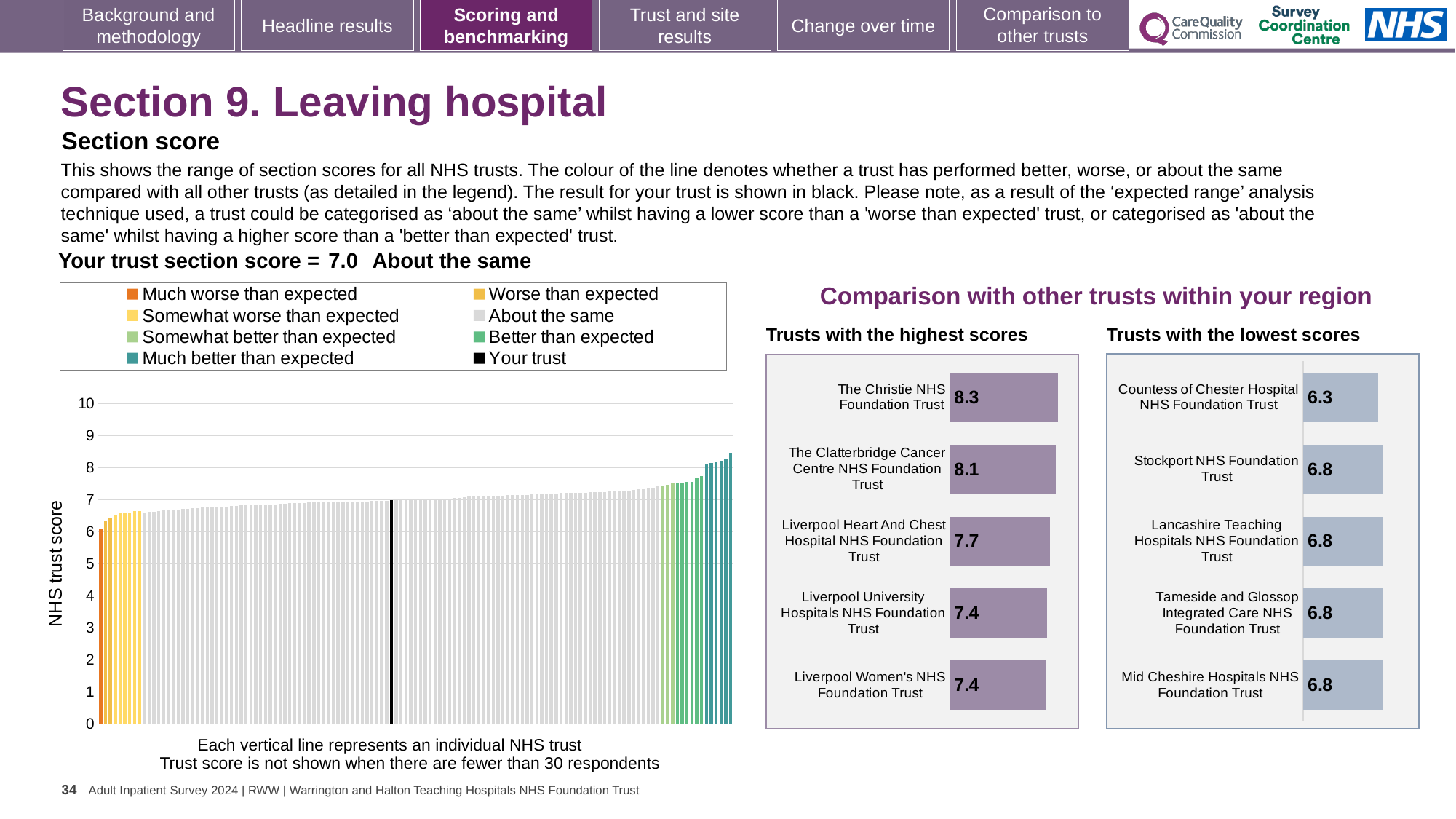
In the 'Trusts with the lowest scores' chart, what is the score for Stockport NHS Foundation Trust? 6.8 In the 'Trusts with the highest scores' chart, is the score for The Clatterbridge Cancer Centre NHS Foundation Trust larger or smaller than the score for Liverpool Women's NHS Foundation Trust? larger How many entries does the legend of the NHS trust score chart on the left list? 8 In the 'Trusts with the lowest scores' chart, how many trusts are shown? 5 In the 'Trusts with the highest scores' chart, which trust has the highest score? The Christie NHS Foundation Trust In the 'Trusts with the highest scores' chart, what is the score for The Christie NHS Foundation Trust? 8.3 In the NHS trust score chart on the left, do the trust scores rise or fall from left to right? rise In the 'Trusts with the lowest scores' chart, which trust has the lowest score? Countess of Chester Hospital NHS Foundation Trust In the NHS trust score chart on the left, what is the section score for your trust? 7.0 In the 'Trusts with the highest scores' chart, what is the score for Liverpool Heart And Chest Hospital NHS Foundation Trust? 7.7 In the 'Trusts with the highest scores' chart, what is the difference between the scores of The Christie NHS Foundation Trust and The Clatterbridge Cancer Centre NHS Foundation Trust? 0.2 In the NHS trust score chart on the left, is the value of the leftmost bar greater or less than 7? less